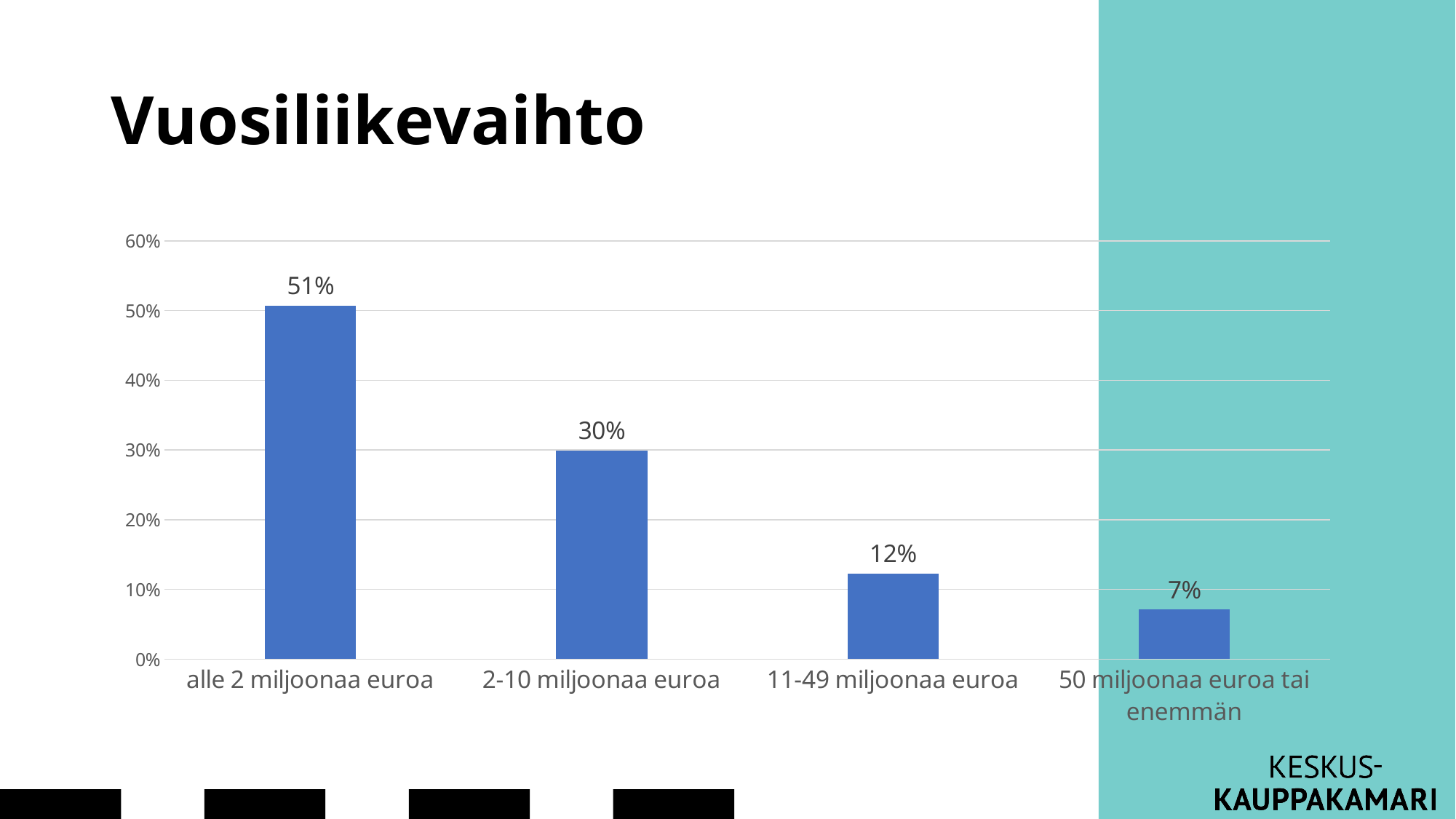
What kind of chart is shown on the slide? bar chart What is the value for "2-10 miljoonaa euroa"? 30% What is the value for "11-49 miljoonaa euroa"? 12% How many categories are shown on the x axis? 4 What is the value for "alle 2 miljoonaa euroa"? 51% What is the difference between the values for "alle 2 miljoonaa euroa" and "2-10 miljoonaa euroa"? 21% Is the value for "2-10 miljoonaa euroa" greater or less than 40%? less Do the values rise or fall from left to right along the x axis? fall What is the value for "50 miljoonaa euroa tai enemmän"? 7% Which category has the highest value? alle 2 miljoonaa euroa Which category has the lowest value? 50 miljoonaa euroa tai enemmän Which is larger, the value for "11-49 miljoonaa euroa" or "50 miljoonaa euroa tai enemmän"? 11-49 miljoonaa euroa